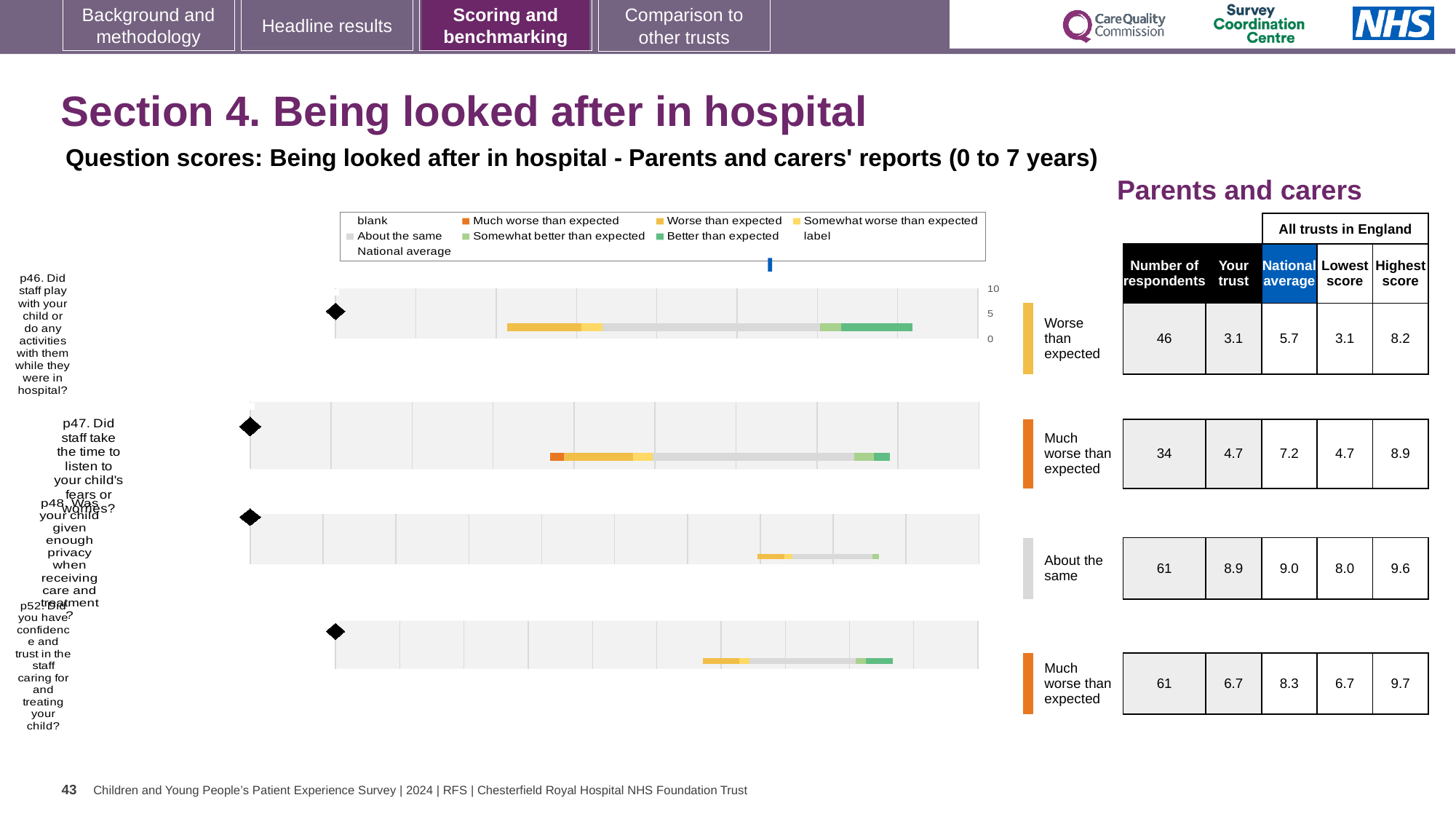
What is the national average score for p47 (Did staff take the time to listen to your child's fears or worries?)? 7.2 Is the 'Your trust' score for p47 larger or smaller than the 'Your trust' score for p52? smaller Which of the four questions has the highest 'Your trust' score? p48. Was your child given enough privacy when receiving care and treatment? What is the 'Your trust' score for p46 (Did staff play with your child or do any activities with them while they were in hospital?)? 3.1 What is the difference between the national average and the 'Your trust' score for p46? 2.6 What is the highest score across all trusts in England for p52 (Did you have confidence and trust in the staff caring for and treating your child?)? 9.7 How many entries does the chart legend list? 9 What benchmark category is shown for p48 (Was your child given enough privacy when receiving care and treatment?)? About the same Which of the four questions has the lowest 'Your trust' score? p46. Did staff play with your child or do any activities with them while they were in hospital? What kind of chart is used to show the question scores on this slide? bar chart How many survey questions (chart rows) are plotted on the slide? 4 How many respondents answered p48 (Was your child given enough privacy when receiving care and treatment?)? 61